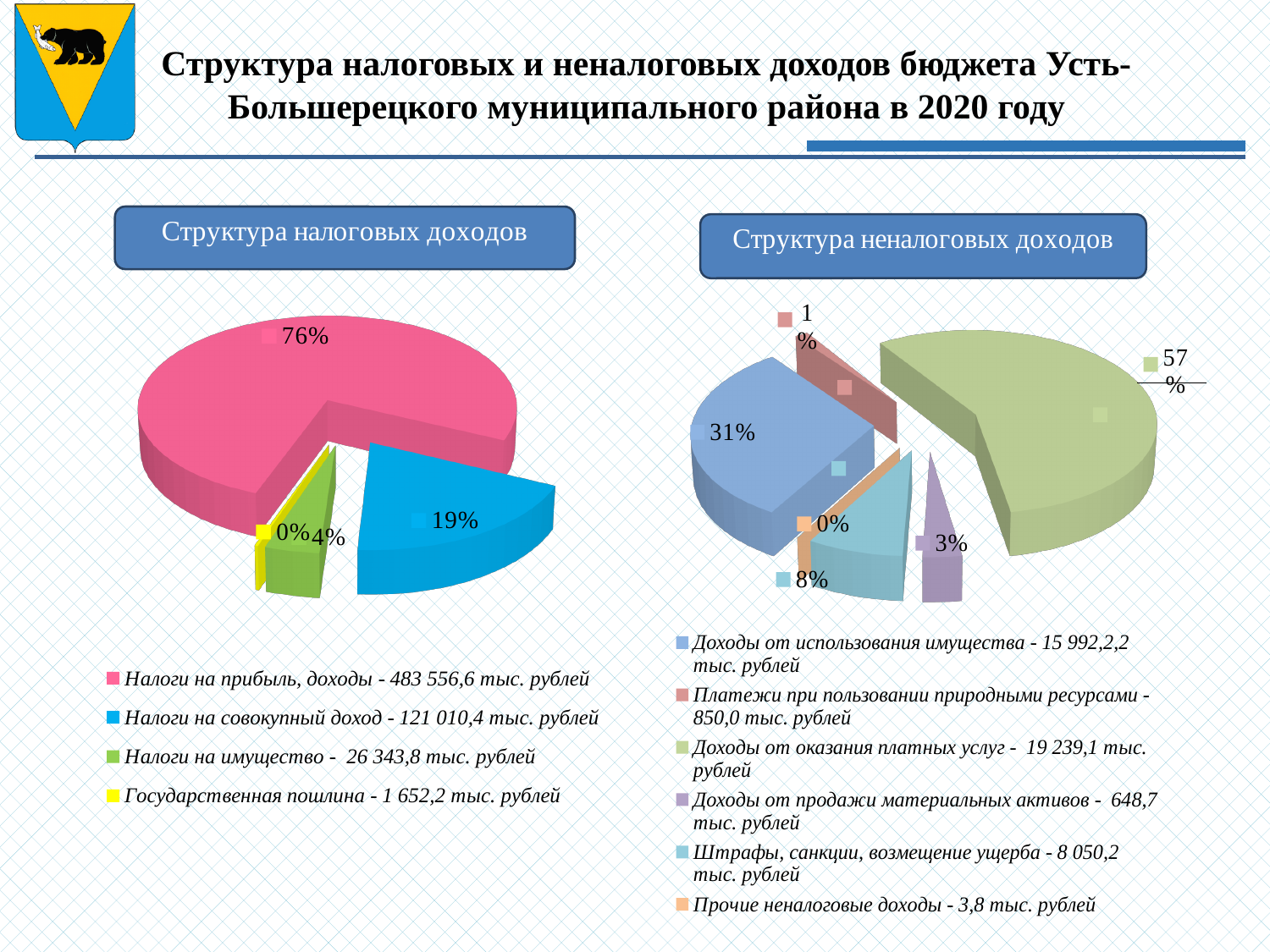
In the "Структура неналоговых доходов" chart, which category has the smallest slice? Прочие неналоговые доходы According to the legend of the "Структура неналоговых доходов" chart, what is the amount for "Штрафы, санкции, возмещение ущерба"? 8 050,2 тыс. рублей In the "Структура налоговых доходов" chart, which category has the largest slice? Налоги на прибыль, доходы According to the legend of the "Структура налоговых доходов" chart, what is the amount for "Налоги на имущество"? 26 343,8 тыс. рублей What kind of chart is used for "Структура налоговых доходов"? Pie chart In the "Структура неналоговых доходов" chart, what share does "Доходы от оказания платных услуг" have? 57% In the "Структура неналоговых доходов" chart, what is the difference in percentage points between "Доходы от оказания платных услуг" and "Доходы от использования имущества"? 26 percentage points In the "Структура неналоговых доходов" chart, how many categories does the legend list? 6 In the "Структура налоговых доходов" chart, what share does "Налоги на прибыль, доходы" have? 76% In the "Структура неналоговых доходов" chart, what share does "Доходы от использования имущества" have? 31% In the "Структура налоговых доходов" chart, how many categories does the legend list? 4